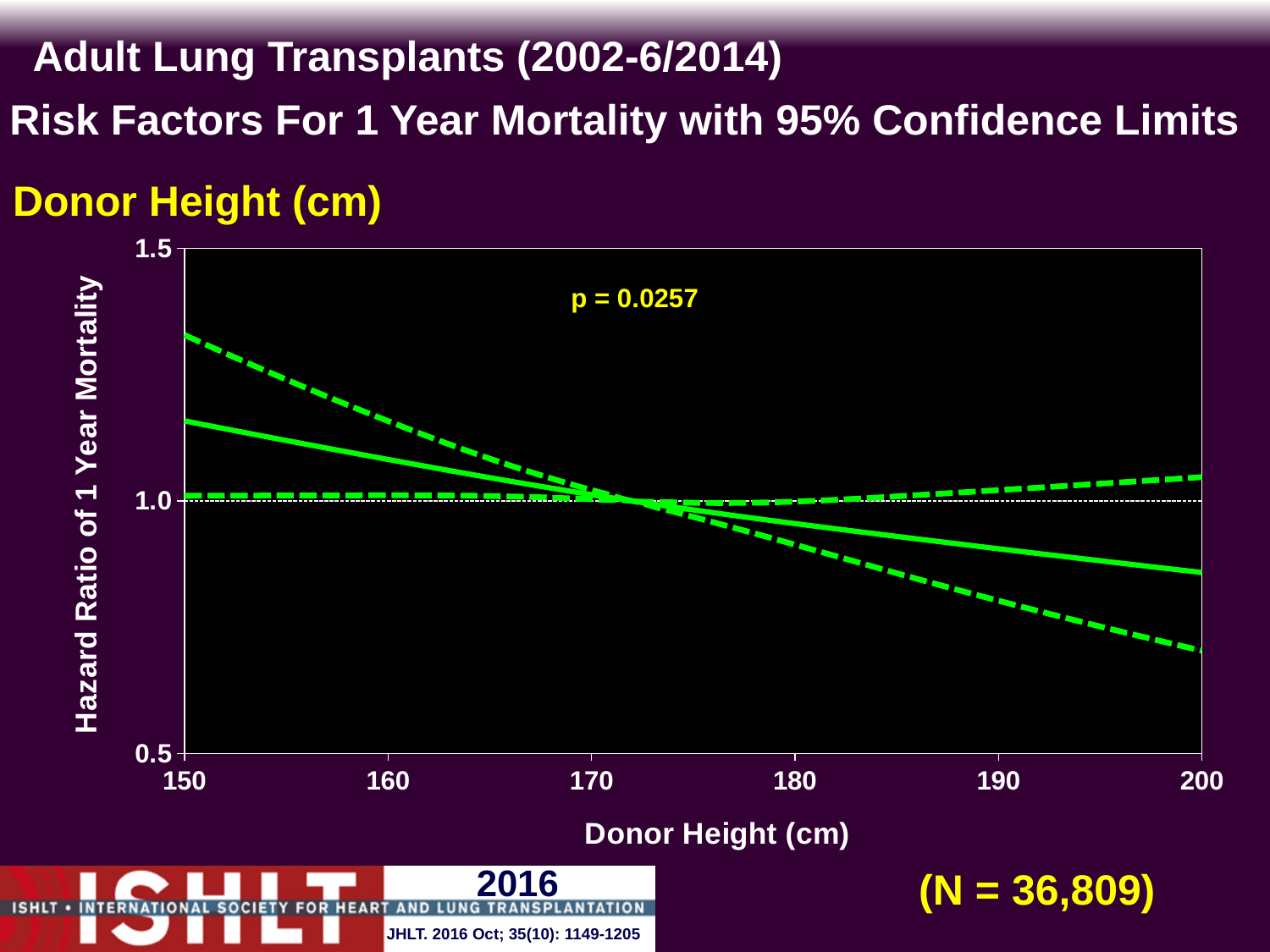
Does the solid hazard ratio line rise or fall as donor height increases from 150 to 200 cm? fall Is the solid-line hazard ratio at a donor height of 150 cm greater or less than 1.0? greater What sample size (N) is shown on the slide? N = 36,809 Is the lower dashed confidence limit at a donor height of 200 cm greater or less than 1.0? less Is the upper dashed confidence limit at a donor height of 150 cm greater or less than 1.5? less Is the solid-line hazard ratio higher at a donor height of 150 cm or at 200 cm? 150 cm What p-value is shown on the chart? p = 0.0257 What kind of chart is shown on the slide? line chart How many lines are plotted on the chart? 3